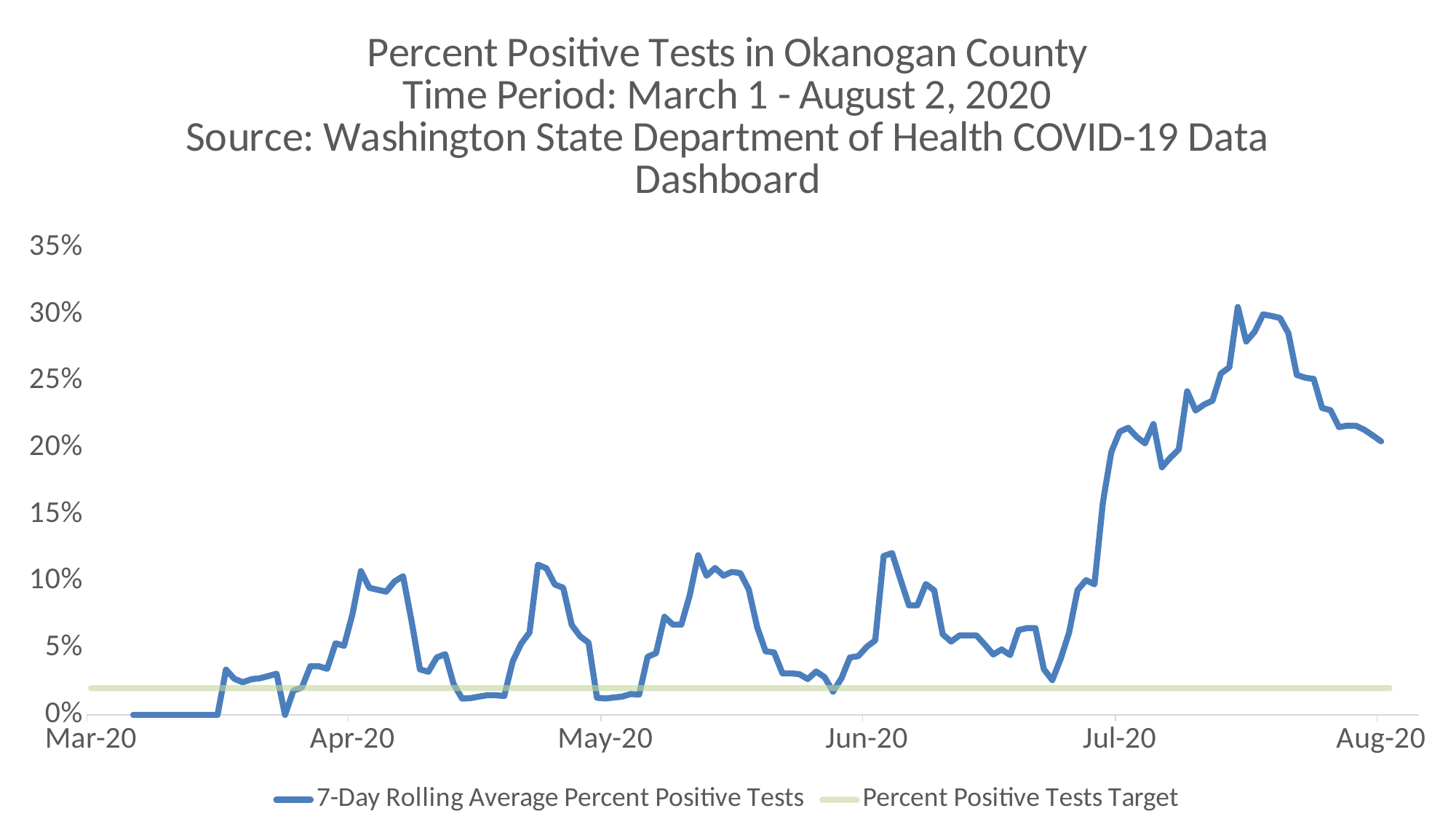
What county does the chart title say the percent positive tests are for? Okanogan County What is the value of the 7-Day Rolling Average Percent Positive Tests at the very start of the series in early March 2020? 0% In which month does the 7-Day Rolling Average Percent Positive Tests reach its highest value? July 2020 What kind of chart is shown on the slide? line chart What are the two series named in the legend? 7-Day Rolling Average Percent Positive Tests; Percent Positive Tests Target Does the 7-Day Rolling Average Percent Positive Tests generally rise or fall from March 2020 to August 2020? rise Is the value of the 7-Day Rolling Average Percent Positive Tests at May-20 greater or less than 5%? less How many series does the legend list? 2 Is the Percent Positive Tests Target line greater or less than 5%? less Is the peak value of the 7-Day Rolling Average Percent Positive Tests in July 2020 greater or less than 25%? greater How many month labels are shown on the x axis? 6